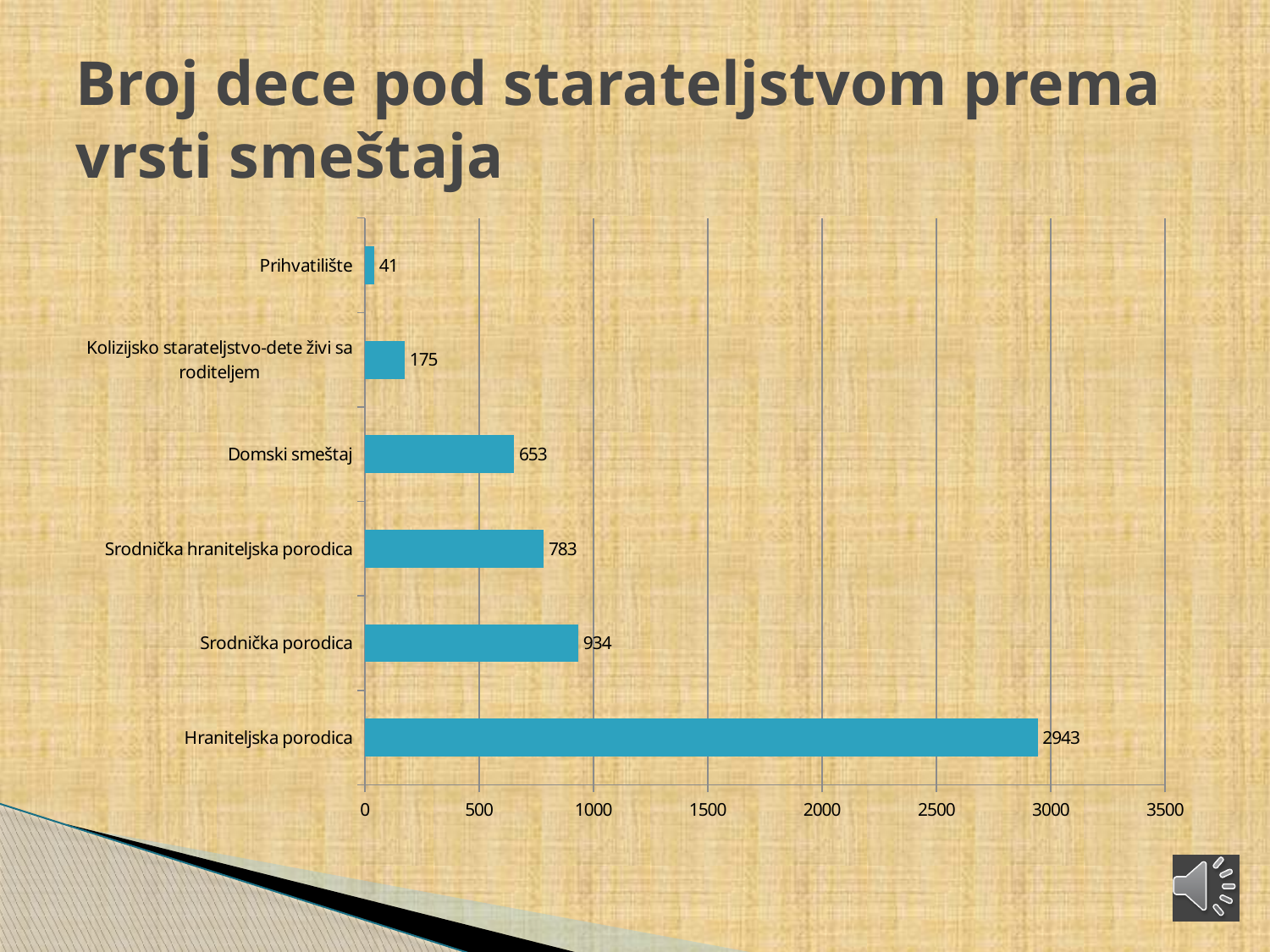
What is the value for Hraniteljska porodica? 2943 What is the value for Kolizijsko starateljstvo-dete živi sa roditeljem? 175 How many categories are shown in the chart? 6 Which is larger, the value for Domski smeštaj or the value for Srodnička hraniteljska porodica? Srodnička hraniteljska porodica What is the difference between the values for Srodnička porodica and Srodnička hraniteljska porodica? 151 What is the title of the slide? Broj dece pod starateljstvom prema vrsti smeštaja Which category has the lowest value? Prihvatilište Is the value for Srodnička porodica greater or less than 1000? less What is the value for Domski smeštaj? 653 What is the value for Prihvatilište? 41 What kind of chart is shown on the slide? bar chart Which category has the highest value? Hraniteljska porodica